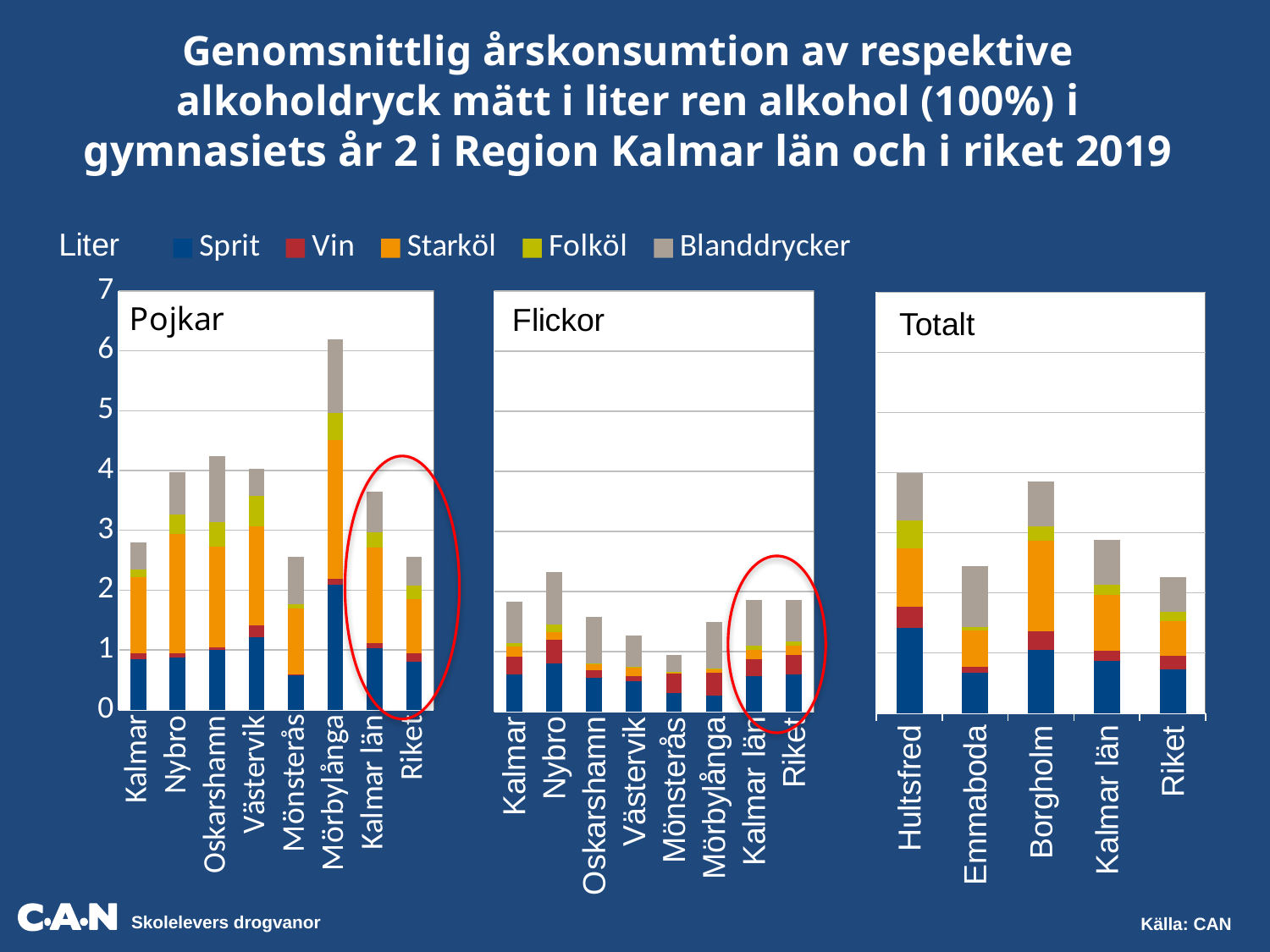
How many categories are shown on the x axis of the Totalt chart? 5 In the Flickor chart, which category has the lowest total bar? Mönsterås How many categories are shown on the x axis of the Flickor chart? 8 In the Totalt chart, is the total for Riket greater or less than 3? less Which series is shown in grey in the legend? Blanddrycker In the Flickor chart, which category has the highest total bar? Nybro In the Totalt chart, which has the larger total bar, Borgholm or Kalmar län? Borgholm What kind of chart is the Pojkar chart? Stacked bar chart In the Pojkar chart, which category has the highest total bar? Mörbylånga In the Pojkar chart, is the total for Mörbylånga greater or less than 5? greater In the Flickor chart, is the total for Mönsterås greater or less than 1? less How many series does the legend list? 5